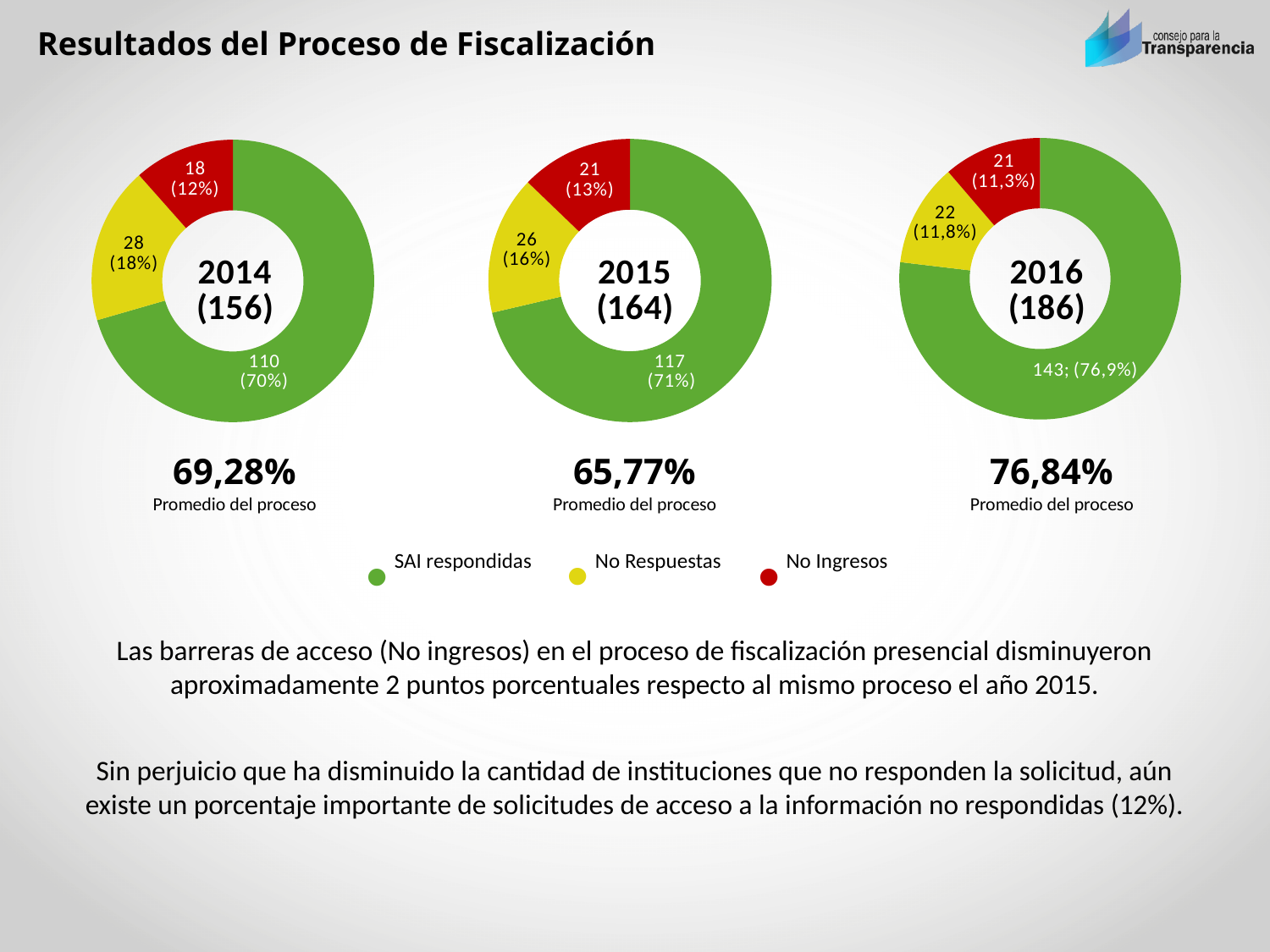
In the 2014 chart, what is the difference between No Respuestas and No Ingresos? 10 In the 2015 chart, which category has the smallest slice? No Ingresos What is the total shown in the centre of the 2015 chart? 164 In the 2016 chart, which is larger, No Respuestas or No Ingresos? No Respuestas What kind of chart is used for each year on the slide? Pie (doughnut) chart How many categories does the legend list? 3 In the 2014 chart, how many SAI respondidas are shown? 110 In the 2015 chart, what percentage share is No Respuestas? 16% In the 2016 chart, what is the value for No Ingresos? 21 In the 2014 chart, which category has the largest slice? SAI respondidas What colour represents No Ingresos in the charts? Red In the 2016 chart, what percentage share is SAI respondidas? 76,9%